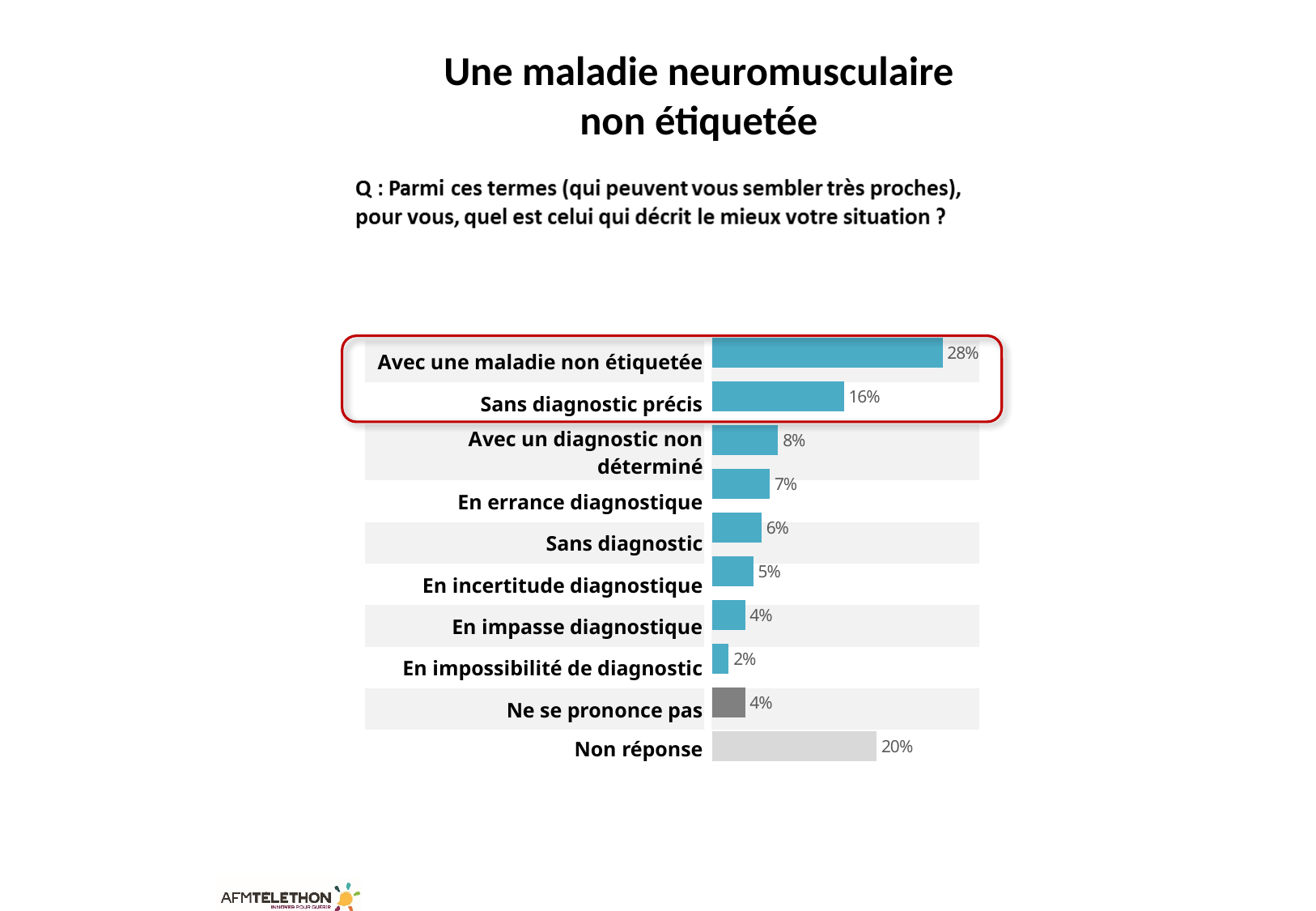
What type of chart is shown on the slide? Bar chart Which category has the lowest percentage? En impossibilité de diagnostic What is the difference in percentage points between "Avec une maladie non étiquetée" and "Sans diagnostic précis"? 12 How many categories are shown in the bar chart? 10 What is the combined percentage of "Avec une maladie non étiquetée" and "Sans diagnostic précis"? 44% What percentage is shown for "Sans diagnostic précis"? 16% What percentage is shown for "Avec une maladie non étiquetée"? 28% What percentage is shown for "En impossibilité de diagnostic"? 2% Which two categories are highlighted with a red outline on the chart? Avec une maladie non étiquetée and Sans diagnostic précis Which is larger: the value for "Non réponse" or the value for "Sans diagnostic précis"? Non réponse Which category has the highest percentage? Avec une maladie non étiquetée What percentage is shown for "Non réponse"? 20%